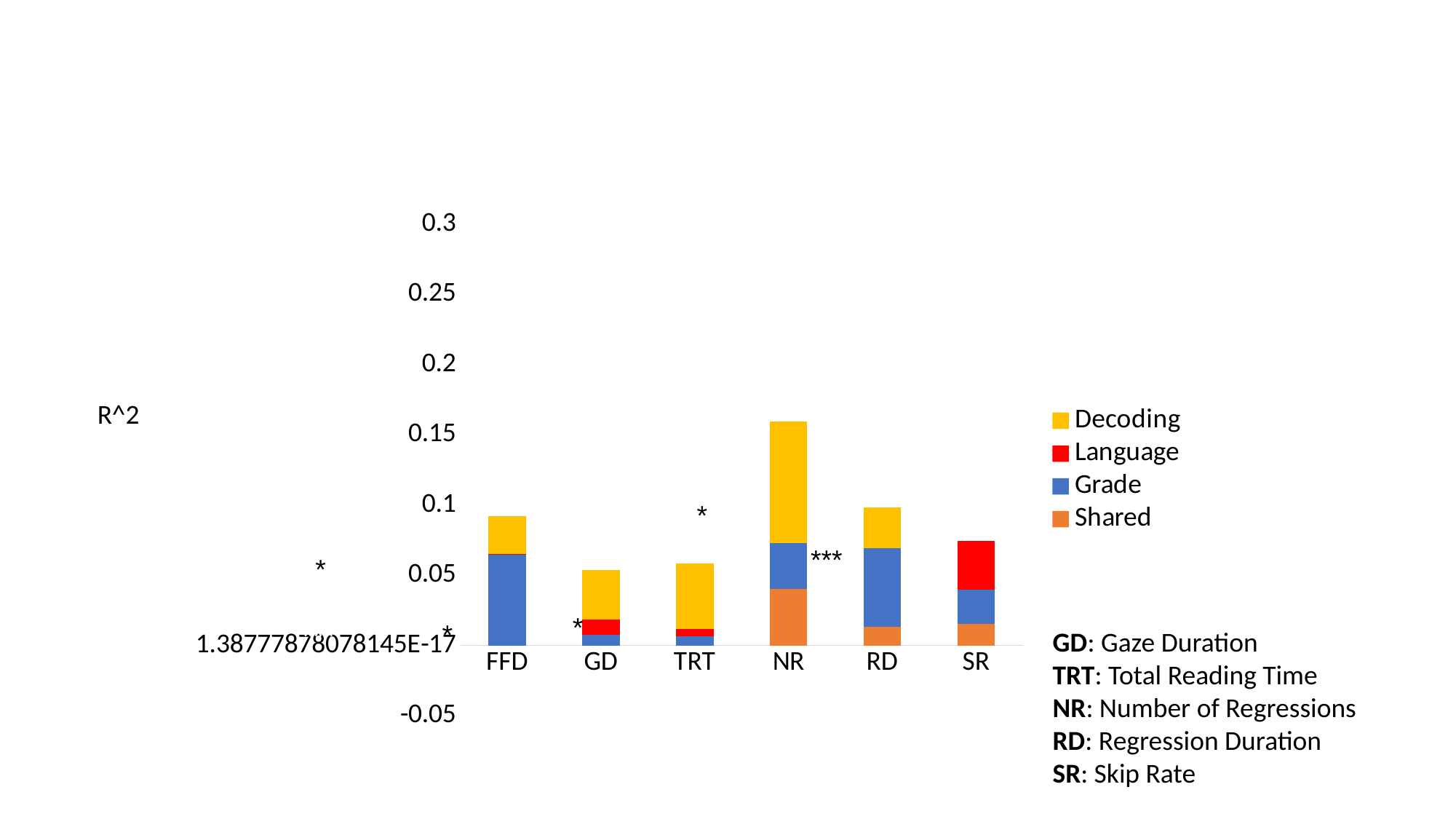
Which colour represents the Decoding series in the chart's legend? Yellow Which category has the largest Language segment in the chart? SR How many categories are shown on the x axis of the chart? 6 How many series does the chart's legend list? 4 What is the label on the vertical axis of the chart? R^2 Which has the larger total bar, NR or FFD? NR Which has the larger total bar, RD or SR? RD Which category has the highest total bar in the chart? NR What kind of chart is shown on the slide? Stacked bar chart Is the total bar for SR greater or less than 0.05? greater Is the total bar for FFD greater or less than 0.1? less Is the total bar for NR greater or less than 0.1? greater